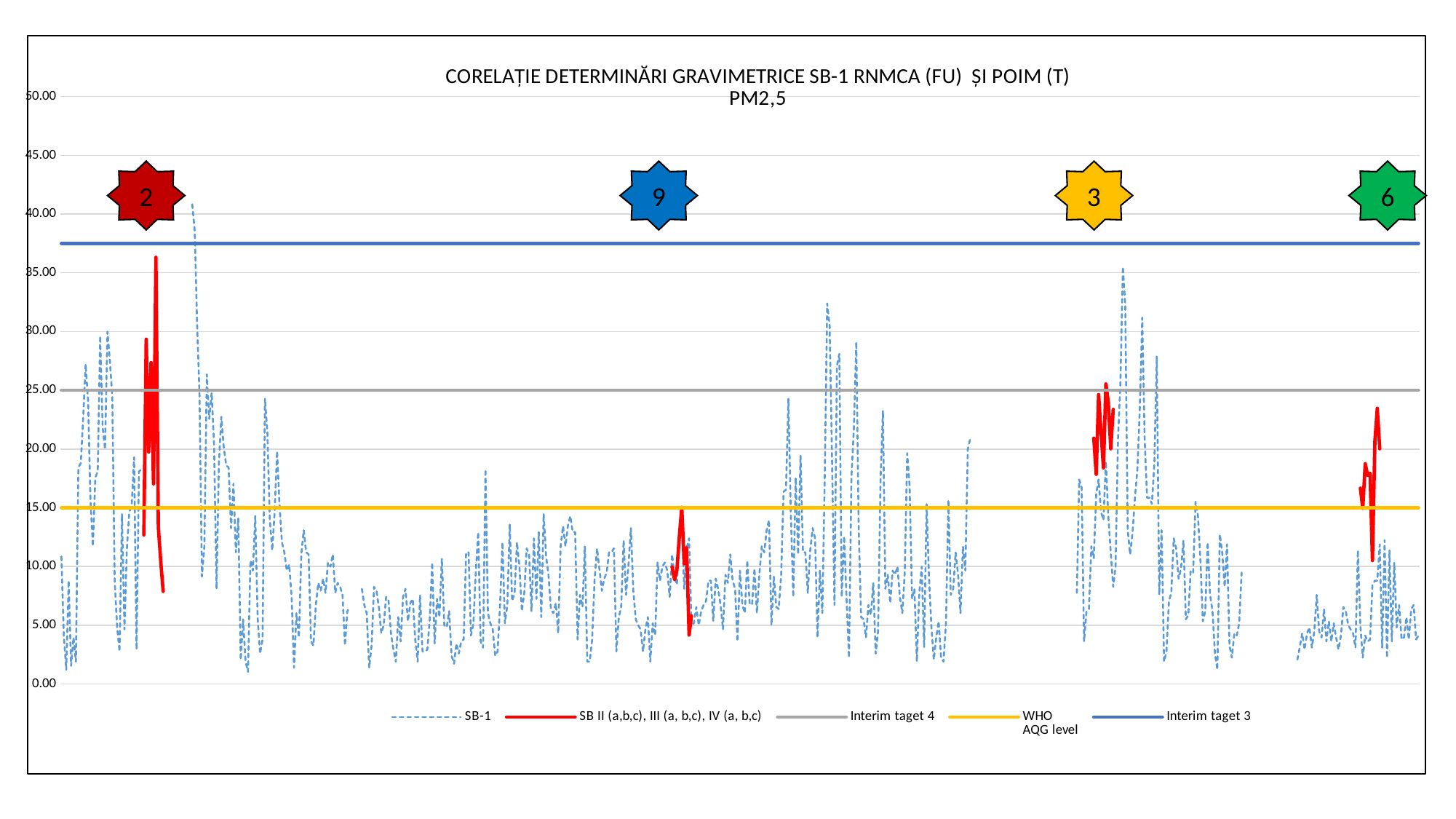
At what value on the y axis does the Interim taget 4 line sit? 25.00 Which of the three horizontal reference lines (Interim taget 4, WHO AQG level, Interim taget 3) is the lowest? WHO AQG level What pollutant is named in the second line of the chart title? PM2,5 Is the value of the Interim taget 3 line greater or less than 40.00? less What is the difference between the Interim taget 4 line and the WHO AQG level line? 10.00 Which is higher, the Interim taget 3 line or the Interim taget 4 line? Interim taget 3 At what value on the y axis does the WHO AQG level line sit? 15.00 What colour is the SB-1 series drawn in? Blue (dashed) Is the value of the Interim taget 3 line greater or less than 35.00? greater How many series does the legend list? 5 What kind of chart is shown on the slide? Line chart Which of the three horizontal reference lines (Interim taget 4, WHO AQG level, Interim taget 3) is the highest? Interim taget 3